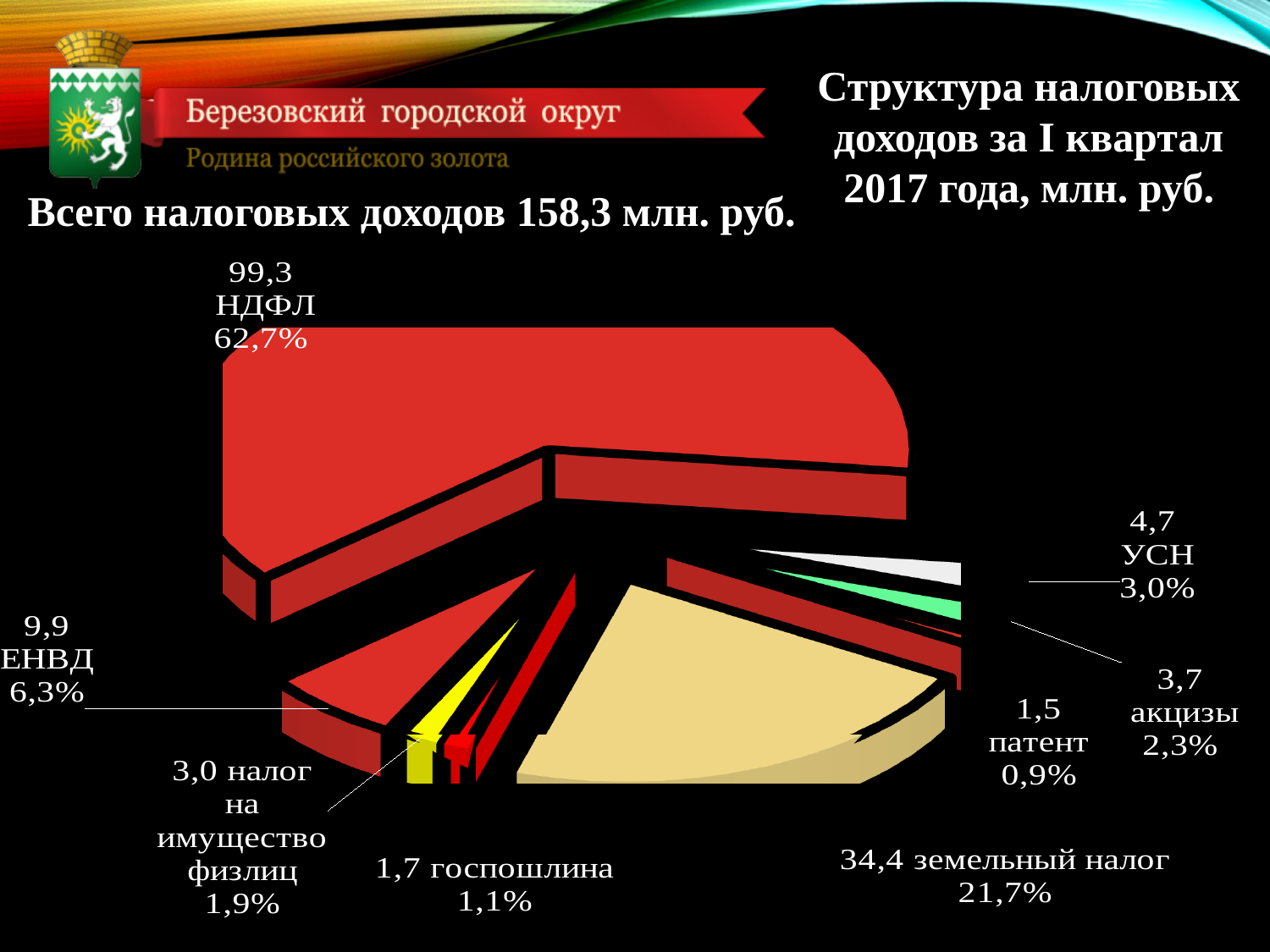
What is the value for ЕНВД? 9,9 What total of tax revenues is stated on the slide? 158,3 млн. руб. What is the value for НДФЛ in the pie chart? 99,3 How many slices does the pie chart have? 8 What share of the pie does земельный налог represent? 21,7% Which category has the largest slice of the pie? НДФЛ Which is larger, the value for акцизы or the value for УСН? УСН What is the difference between the values for НДФЛ and земельный налог? 64,9 What share of the pie does УСН represent? 3,0% Which category has the smallest slice of the pie? патент What kind of chart is shown on the slide? pie chart What is the value for госпошлина? 1,7